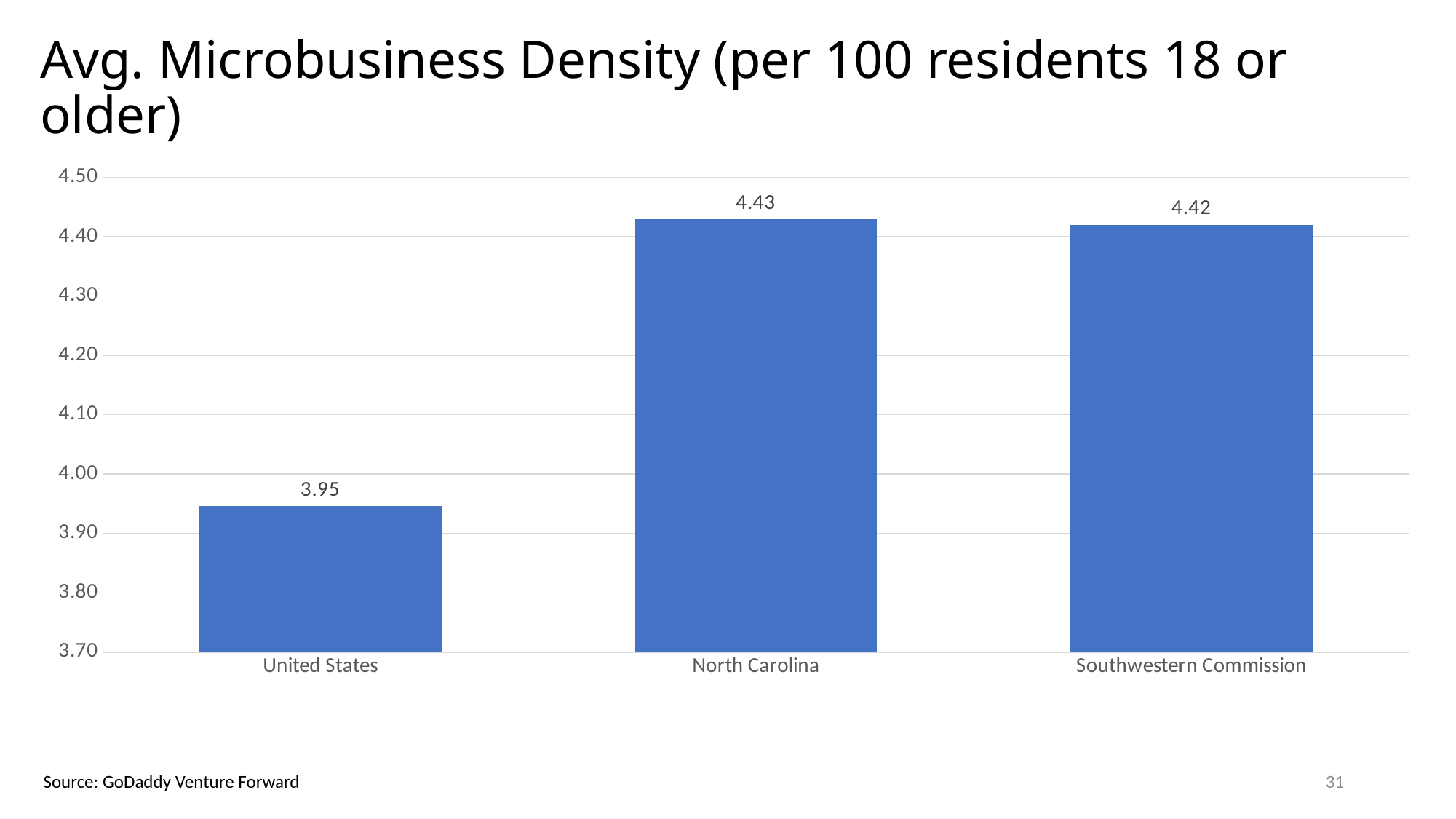
Is the value for the United States greater or less than 4.00? less How many categories are shown on the chart? 3 What source is cited for the chart? GoDaddy Venture Forward Is the value for Southwestern Commission greater or less than 4.30? greater What is the difference between the Southwestern Commission value and the United States value? 0.47 What kind of chart is shown on the slide? Bar chart What is the average microbusiness density for the United States? 3.95 Which is larger, the value for the United States or the value for North Carolina? North Carolina What is the difference between the North Carolina value and the United States value? 0.48 What is the average microbusiness density for North Carolina? 4.43 Which category has the lowest average microbusiness density? United States What is the average microbusiness density for Southwestern Commission? 4.42